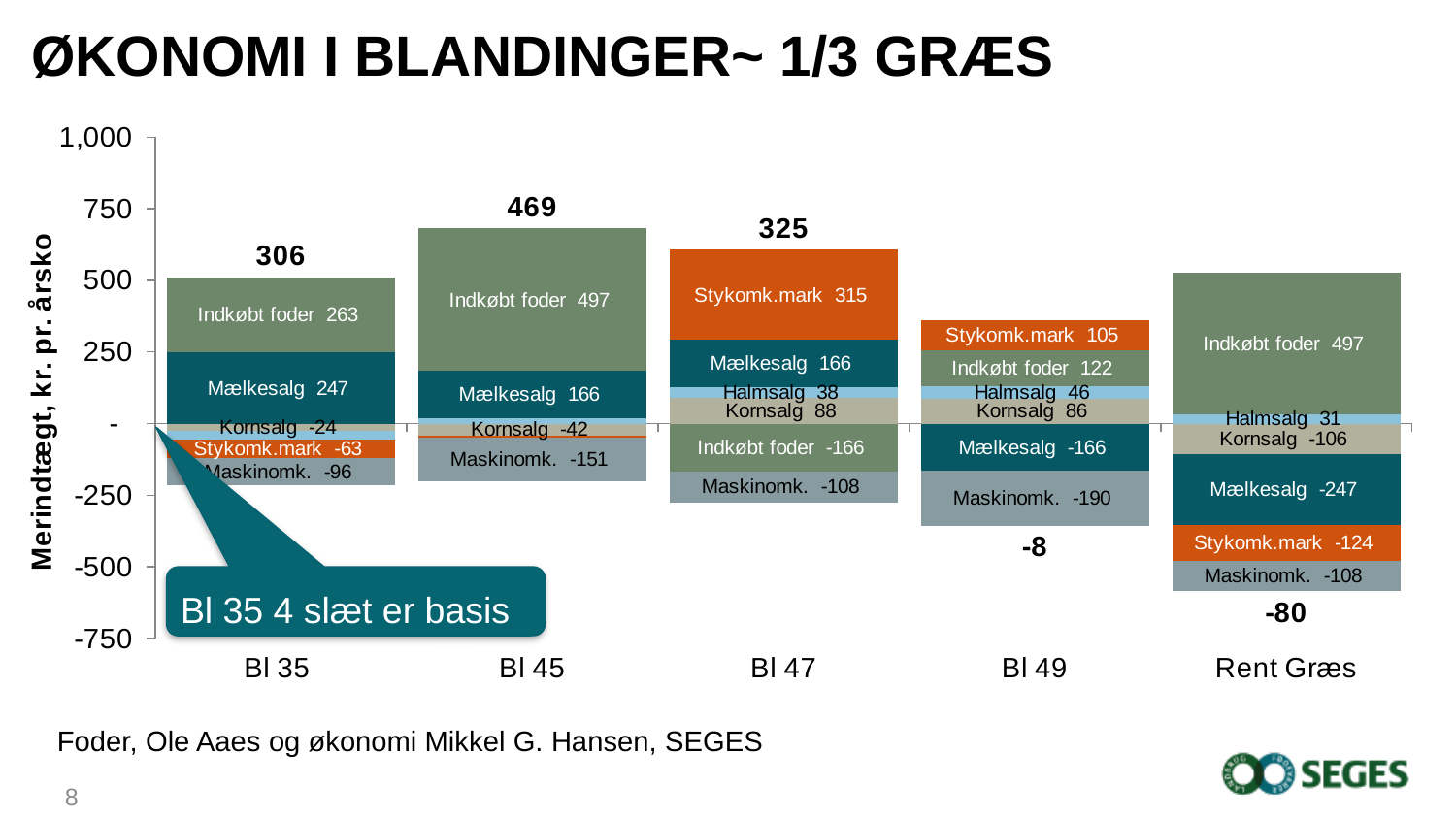
What is the y-axis title of the chart? Merindtægt, kr. pr. årsko What is the difference between the total for Bl 45 and the total for Bl 35? 163 What is the value of Maskinomk. for Bl 49? -190 Which category has the highest total value printed above its bar? Bl 45 Which category has the lowest total value printed on the chart? Rent Græs What kind of chart is shown on the slide? bar chart What is the value of Kornsalg for Bl 35? -24 What is the value of Indkøbt foder for Bl 45? 497 How many categories are shown on the x axis of the chart? 5 Which has the larger total, Bl 47 or Bl 35? Bl 47 What is the value of Mælkesalg for Bl 47? 166 What is the value of Stykomk.mark for Rent Græs? -124